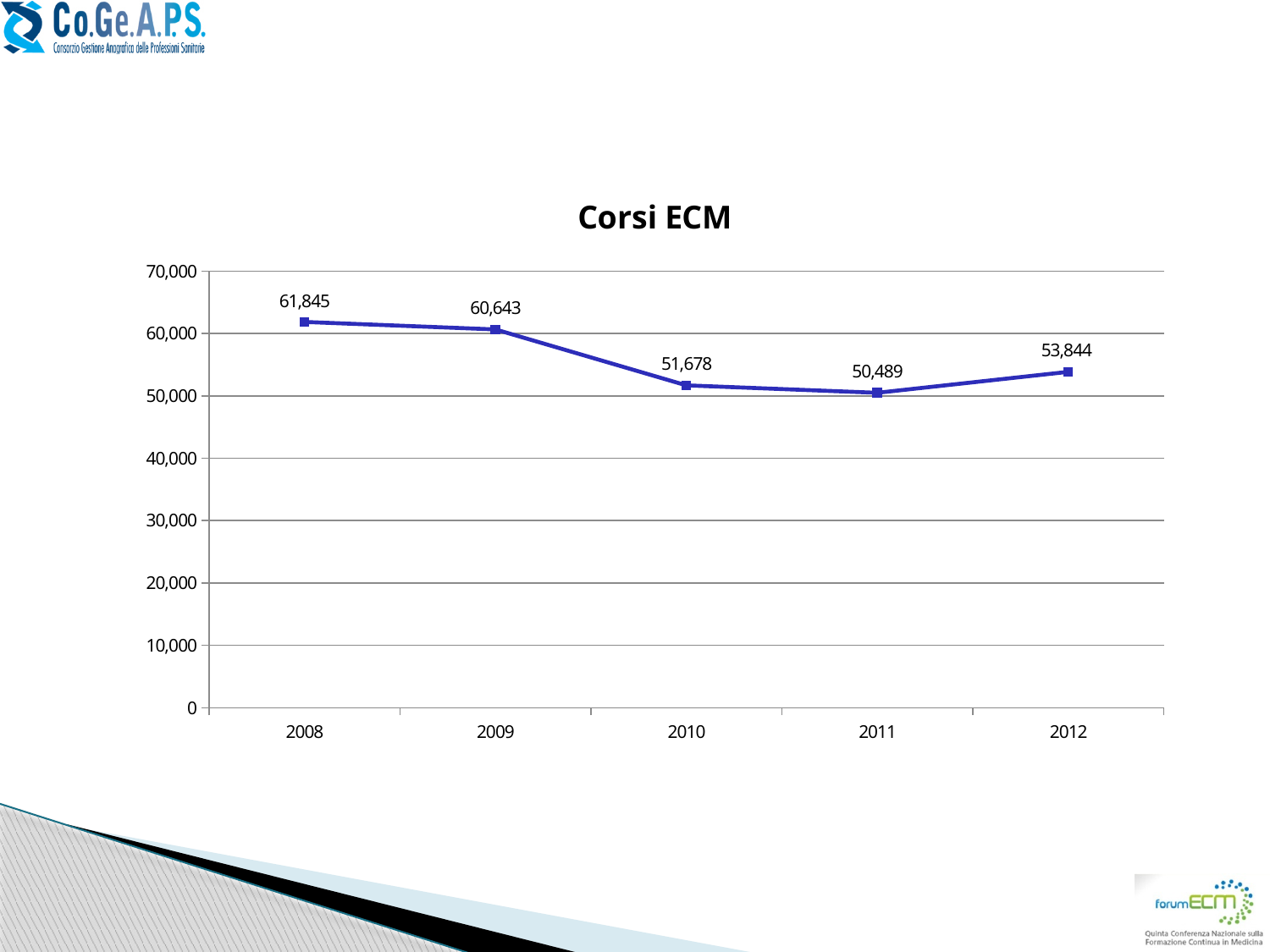
What is the value for 2012? 53,844 How many years are plotted on the chart? 5 What is the value for 2011? 50,489 What is the title of the chart? Corsi ECM What is the value for 2008? 61,845 Which year has the highest value? 2008 What is the difference between the values for 2009 and 2010? 8,965 Which is larger, the value for 2010 or the value for 2012? 2012 Is the value for 2011 greater or less than 60,000? less What is the difference between the values for 2008 and 2012? 8,001 What kind of chart is shown? line chart Which year has the lowest value? 2011